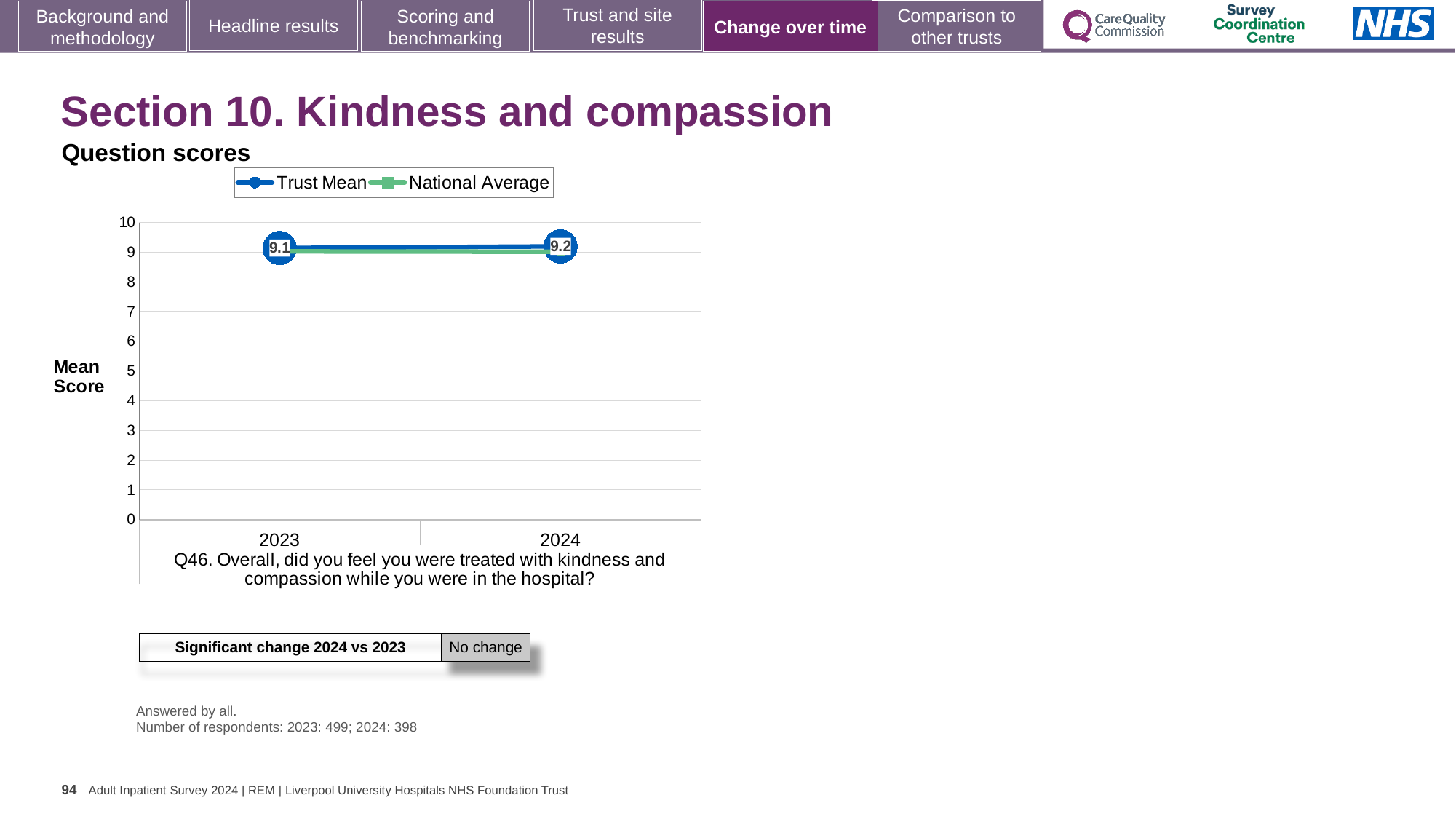
What is the Trust Mean for 2024? 9.2 What is the Trust Mean for 2023? 9.1 Which year has the higher Trust Mean, 2023 or 2024? 2024 Does the Trust Mean rise or fall from 2023 to 2024? rise How many series does the legend list? 2 Is the Trust Mean for 2023 greater or less than 5? greater What kind of chart is shown on the slide? line chart What is the label on the y axis of the chart? Mean Score What are the two series named in the legend? Trust Mean and National Average Is the National Average for 2024 greater or less than 8? greater How many years are plotted on the x axis? 2 By how much did the Trust Mean change from 2023 to 2024? 0.1